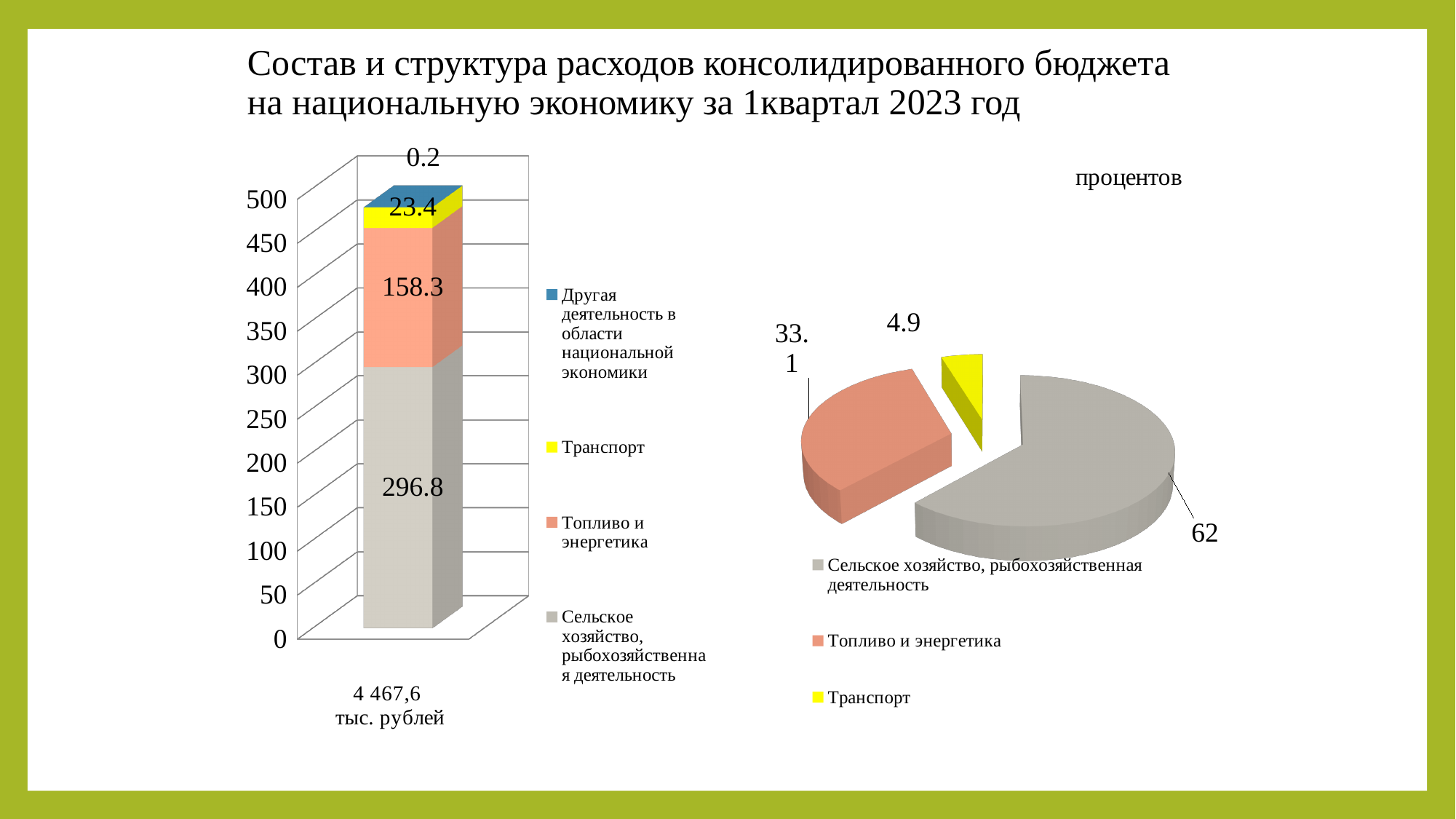
In the stacked bar chart on the left, what is the value for Топливо и энергетика? 158.3 In the pie chart on the right, what is the value for Транспорт? 4.9 In the stacked bar chart on the left, what is the difference between the values for Сельское хозяйство, рыбохозяйственная деятельность and Топливо и энергетика? 138.5 In the pie chart on the right, how many slices are there? 3 In the stacked bar chart on the left, which series has the smallest value? Другая деятельность в области национальной экономики In the pie chart on the right, what is the difference between the values for Сельское хозяйство, рыбохозяйственная деятельность and Топливо и энергетика? 28.9 In the stacked bar chart on the left, what is the total of the stacked bar? 478.7 What kind of chart is shown on the right side of the slide? Pie chart In the stacked bar chart on the left, what is the value for Сельское хозяйство, рыбохозяйственная деятельность? 296.8 In the stacked bar chart on the left, how many series does the legend list? 4 In the stacked bar chart on the left, what is the value for Транспорт? 23.4 In the pie chart on the right, which category has the largest share? Сельское хозяйство, рыбохозяйственная деятельность